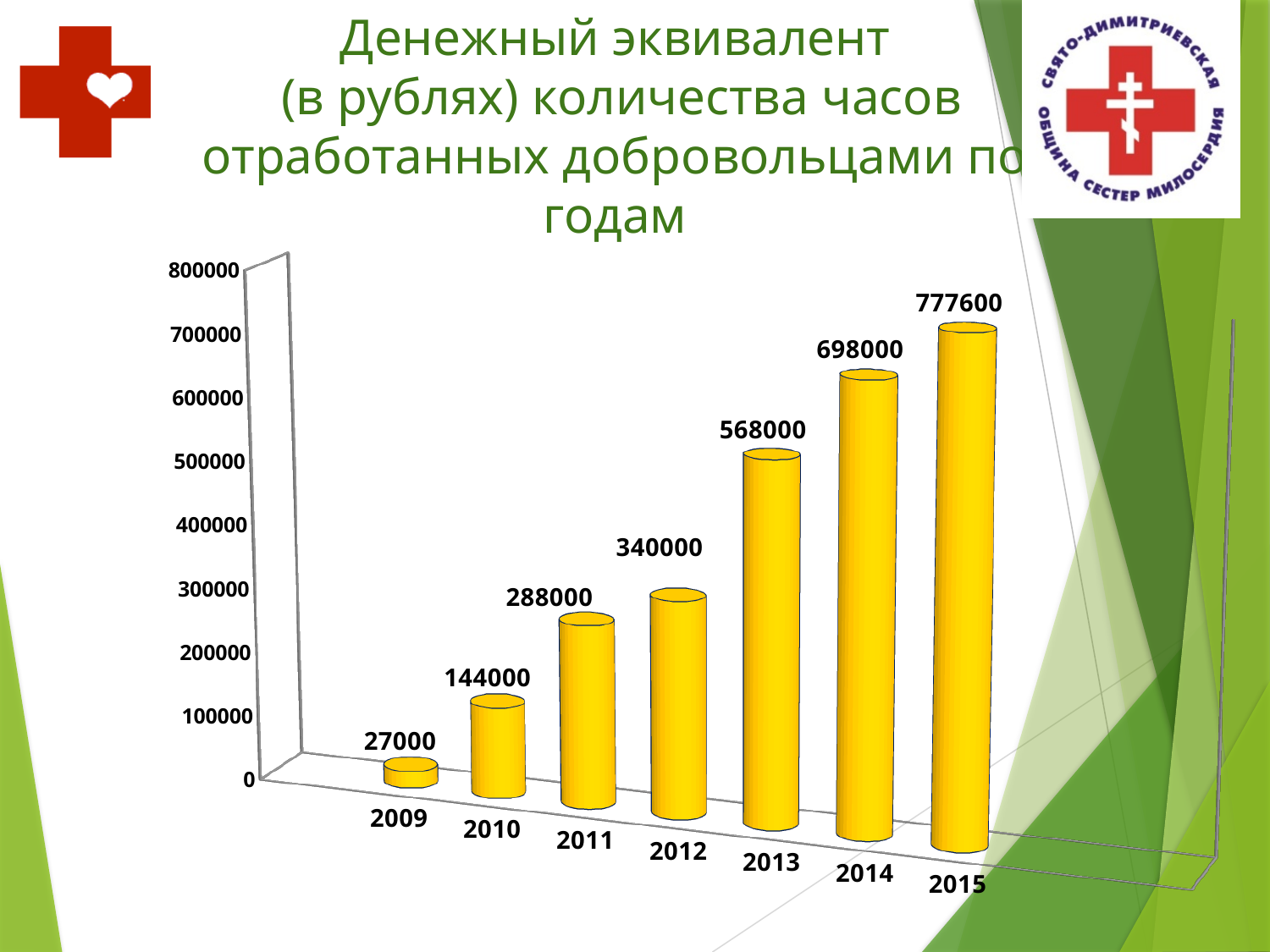
How many years are shown on the chart? 7 Which is larger, the value for 2013 or the value for 2012? 2013 What colour are the bars on the chart? yellow What kind of chart is this? bar chart Which year has the lowest value? 2009 What is the value for 2015? 777600 Which year has the highest value? 2015 Do the values rise or fall from 2009 to 2015? rise What is the difference between the values for 2011 and 2010? 144000 What is the value for 2012? 340000 What is the value for 2009? 27000 What is the difference between the values for 2015 and 2014? 79600